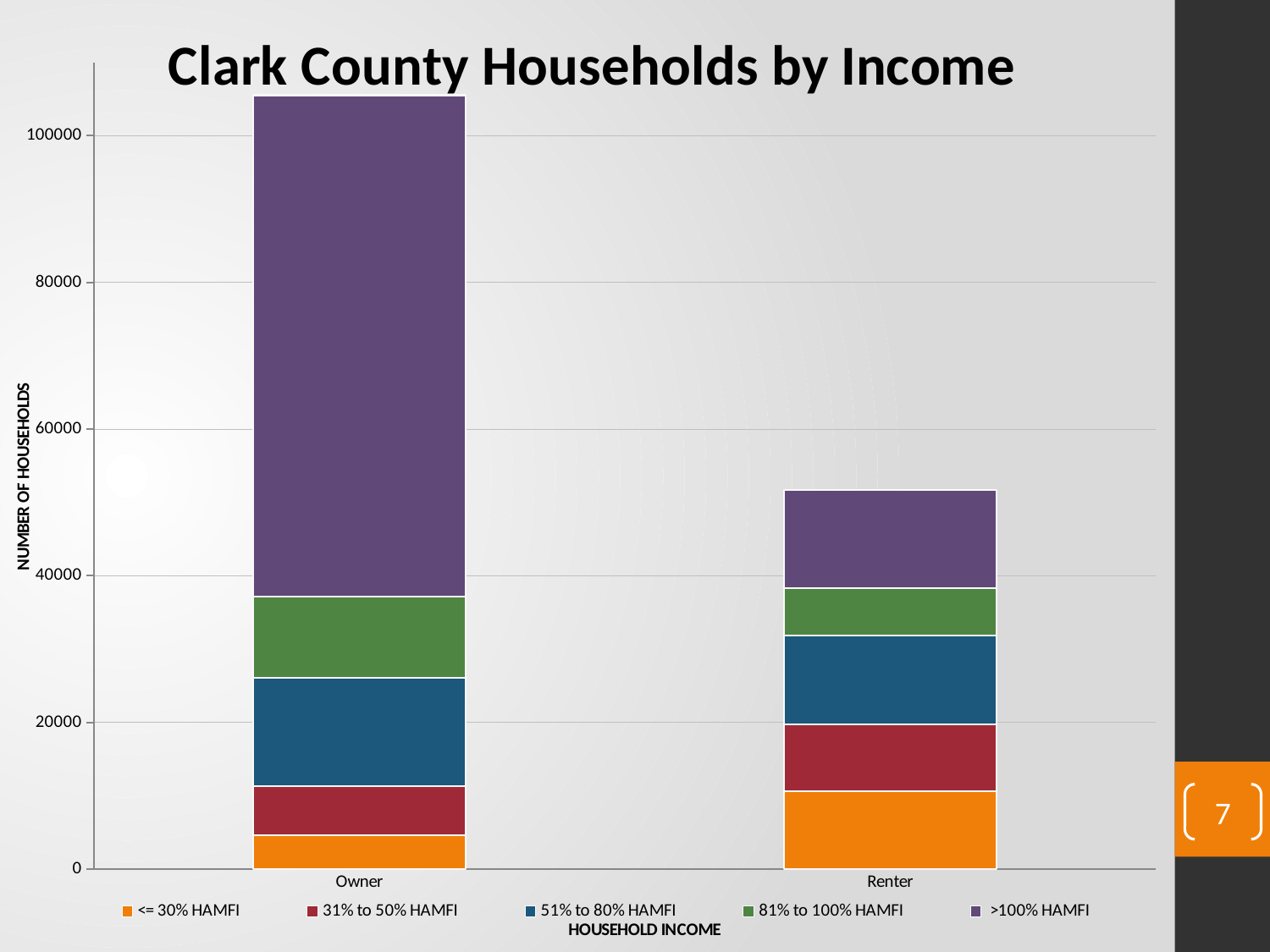
Which category has the shorter stacked bar? Renter What kind of chart is shown on the slide? Stacked bar chart Which category has the taller stacked bar, Owner or Renter? Owner Is the total for Renter greater or less than 60000? less What is the title of the chart? Clark County Households by Income Which is larger, the >100% HAMFI segment for Owner or for Renter? Owner What is the label of the vertical axis? NUMBER OF HOUSEHOLDS Is the total for Owner greater or less than 100000? greater How many categories are shown on the x axis? 2 Is the total for Renter greater or less than 40000? greater Which is larger, the <= 30% HAMFI segment for Owner or for Renter? Renter How many series does the legend list? 5